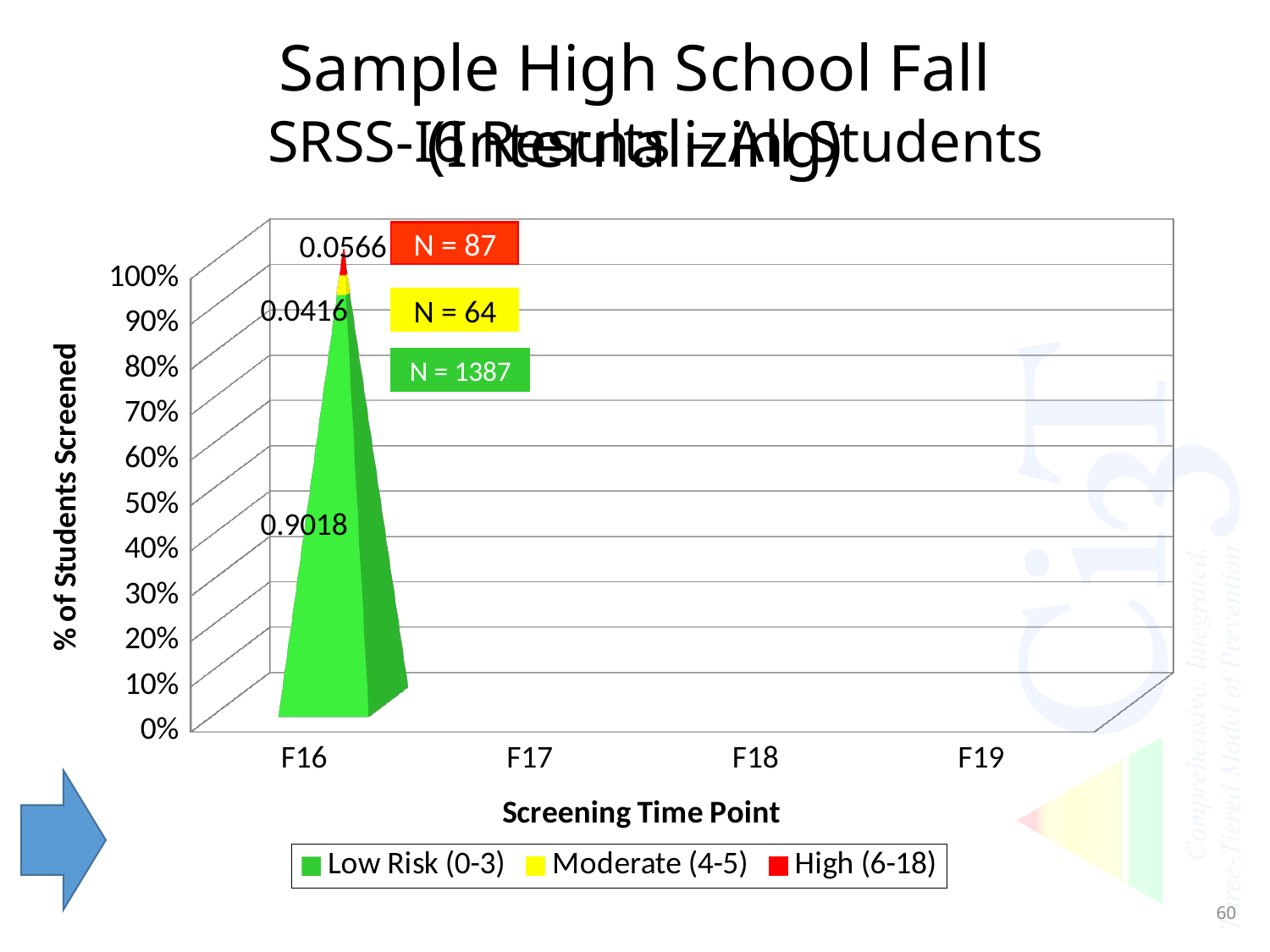
Which series has the smallest value at F16? Moderate (4-5) What is the value of the High (6-18) series at F16? 0.0566 How many screening time points are shown on the x axis? 4 What is the value of the Moderate (4-5) series at F16? 0.0416 What is the value of the Low Risk (0-3) series at F16? 0.9018 At F16, which is larger: the High (6-18) value or the Moderate (4-5) value? High (6-18) Which series has the largest value at F16? Low Risk (0-3) What N value is shown in the green box on the chart? N = 1387 Is the Low Risk (0-3) value at F16 greater or less than 50%? greater How many series does the legend list? 3 What is the difference between the Low Risk (0-3) value and the High (6-18) value at F16? 0.8452 What are the three legend entries of the chart? Low Risk (0-3), Moderate (4-5), High (6-18)